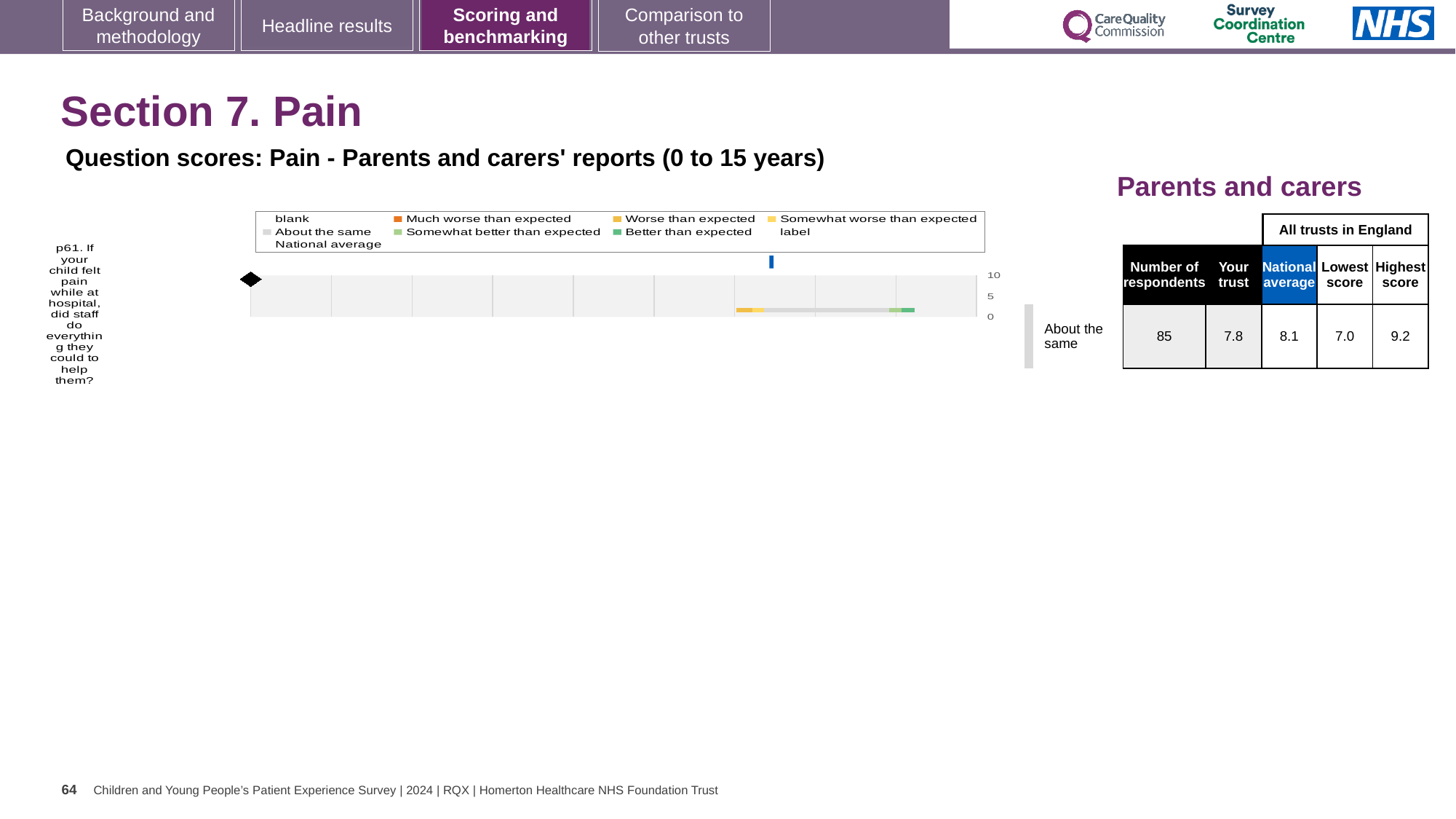
According to the table, what is the lowest score among all trusts in England for question p61? 7.0 According to the table, what is the 'Your trust' score for question p61? 7.8 What kind of chart is shown on the slide? bar chart According to the table, how many respondents answered question p61? 85 What is the difference between the highest score and the lowest score for question p61? 2.2 According to the table, what is the highest score among all trusts in England for question p61? 9.2 According to the table, what is the national average score for question p61? 8.1 Which benchmarking category is question p61 assigned to? About the same Which question number is plotted in the chart? p61 What is the difference between the national average and the 'Your trust' score for question p61? 0.3 Which is larger for question p61: the 'Your trust' score or the national average? National average How many survey questions are plotted in the chart? 1